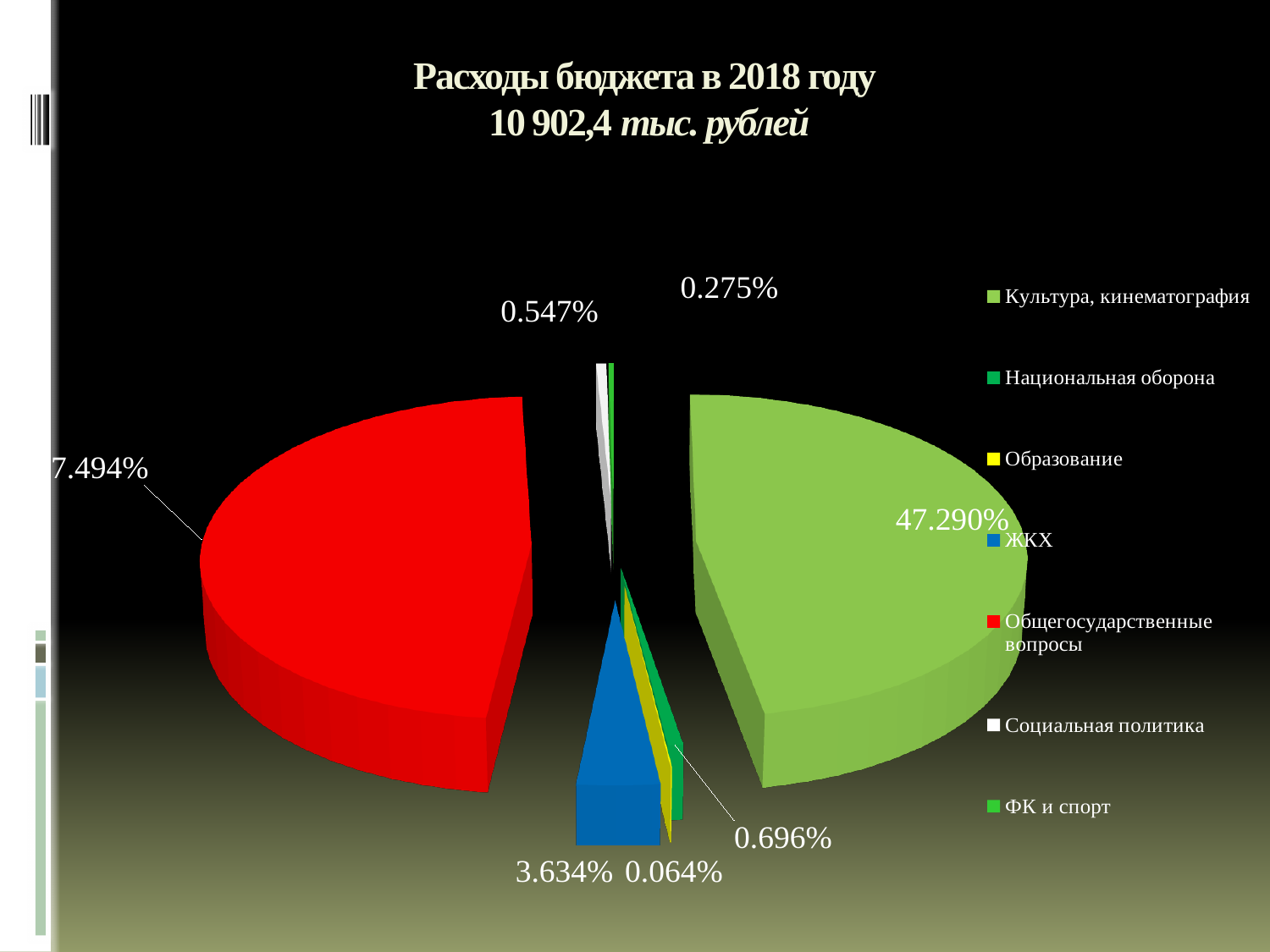
What share of the pie does Национальная оборона have? 0.696% What type of chart is shown on the slide? pie chart What share of the pie does Образование have? 0.064% How many categories does the legend list? 7 What is the difference between the shares for ЖКХ and Национальная оборона? 2.938% What share of the pie does ЖКХ have? 3.634% Which category has the smallest share of the pie? Образование What is the title of the chart? Расходы бюджета в 2018 году 10 902,4 тыс. рублей What share of the pie does ФК и спорт have? 0.275% What share of the pie does Культура, кинематография have? 47.290% Which is larger, the share for ЖКХ or the share for Национальная оборона? ЖКХ What share of the pie does Социальная политика have? 0.547%